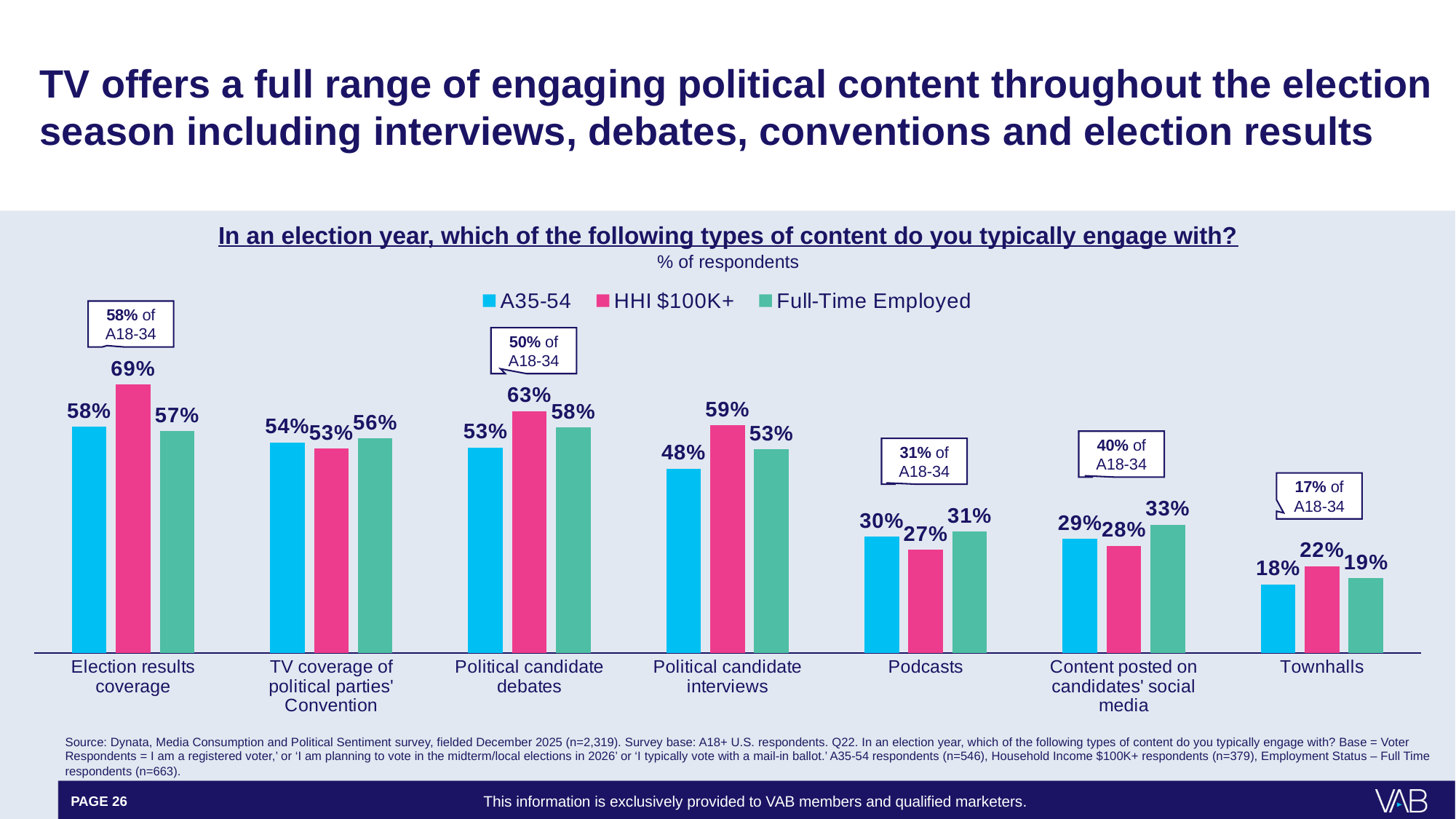
What kind of chart is shown on the slide? Bar chart According to the callout, what percentage of A18-34 respondents engage with townhalls? 17% What colour represents the HHI $100K+ series in the chart? Pink How many series does the legend list? 3 What percentage of Full-Time Employed respondents engage with content posted on candidates' social media? 33% What percentage of HHI $100K+ respondents engage with election results coverage? 69% What is the difference between the HHI $100K+ and A35-54 values for political candidate debates? 10 percentage points What is the value for A35-54 respondents for political candidate interviews? 48% How many content types are shown on the x axis? 7 For podcasts, which is larger: the A35-54 value or the HHI $100K+ value? A35-54 Which content type has the highest value for the Full-Time Employed series? Political candidate debates Which content type has the lowest value for the HHI $100K+ series? Townhalls